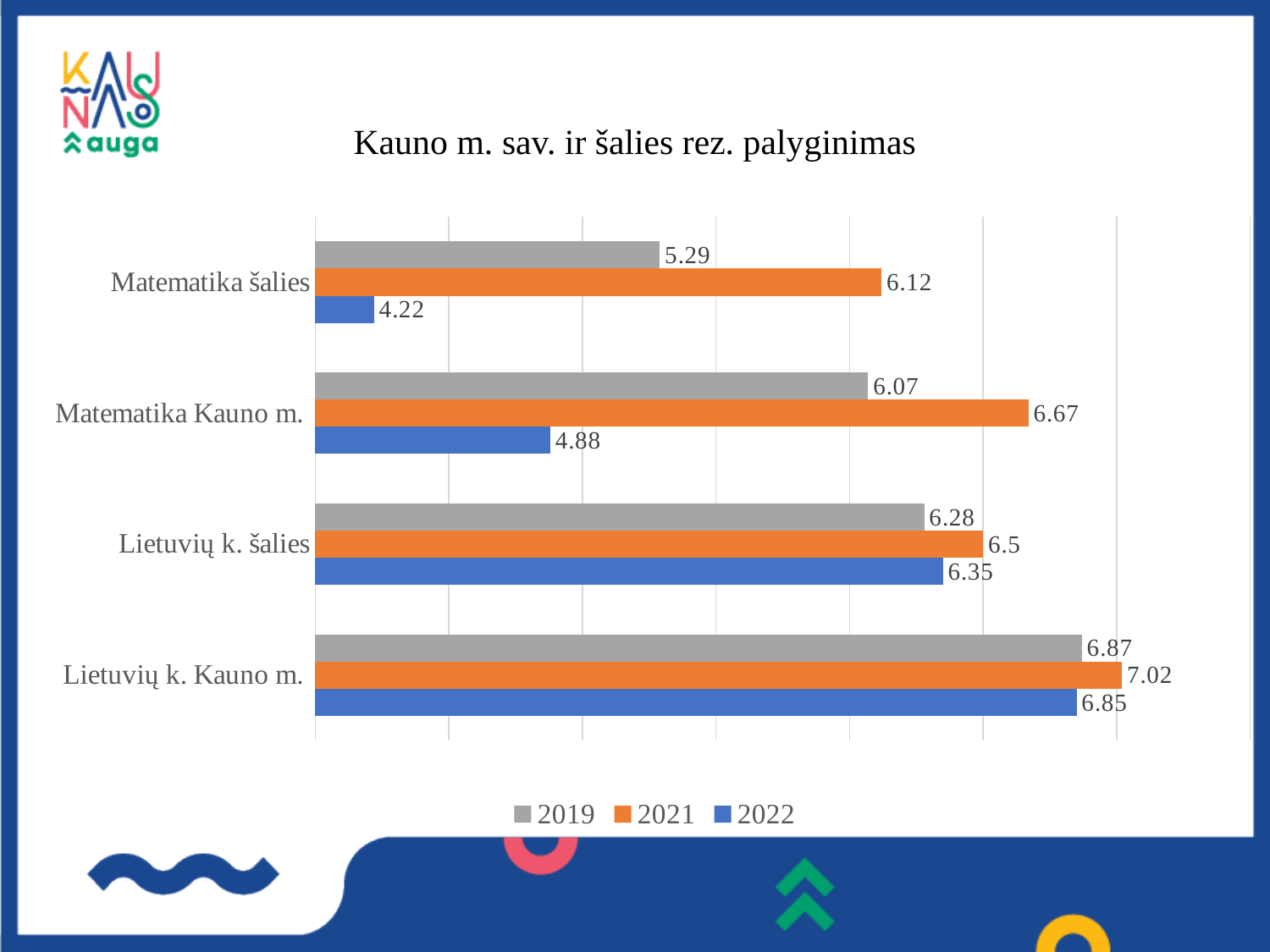
Which is larger: the 2019 value for Lietuvių k. šalies or the 2019 value for Matematika šalies? Lietuvių k. šalies What is the 2021 value for Lietuvių k. Kauno m.? 7.02 How many categories are shown on the chart? 4 What is the difference between the 2021 and 2022 values for Matematika Kauno m.? 1.79 Which category has the highest 2021 value? Lietuvių k. Kauno m. What kind of chart is shown on the slide? Bar chart What is the 2022 value for Matematika šalies? 4.22 What is the 2019 value for Matematika Kauno m.? 6.07 What is the title of the chart? Kauno m. sav. ir šalies rez. palyginimas Which colour represents the 2021 series in the legend? Orange How many series does the legend list? 3 Which category has the lowest 2022 value? Matematika šalies